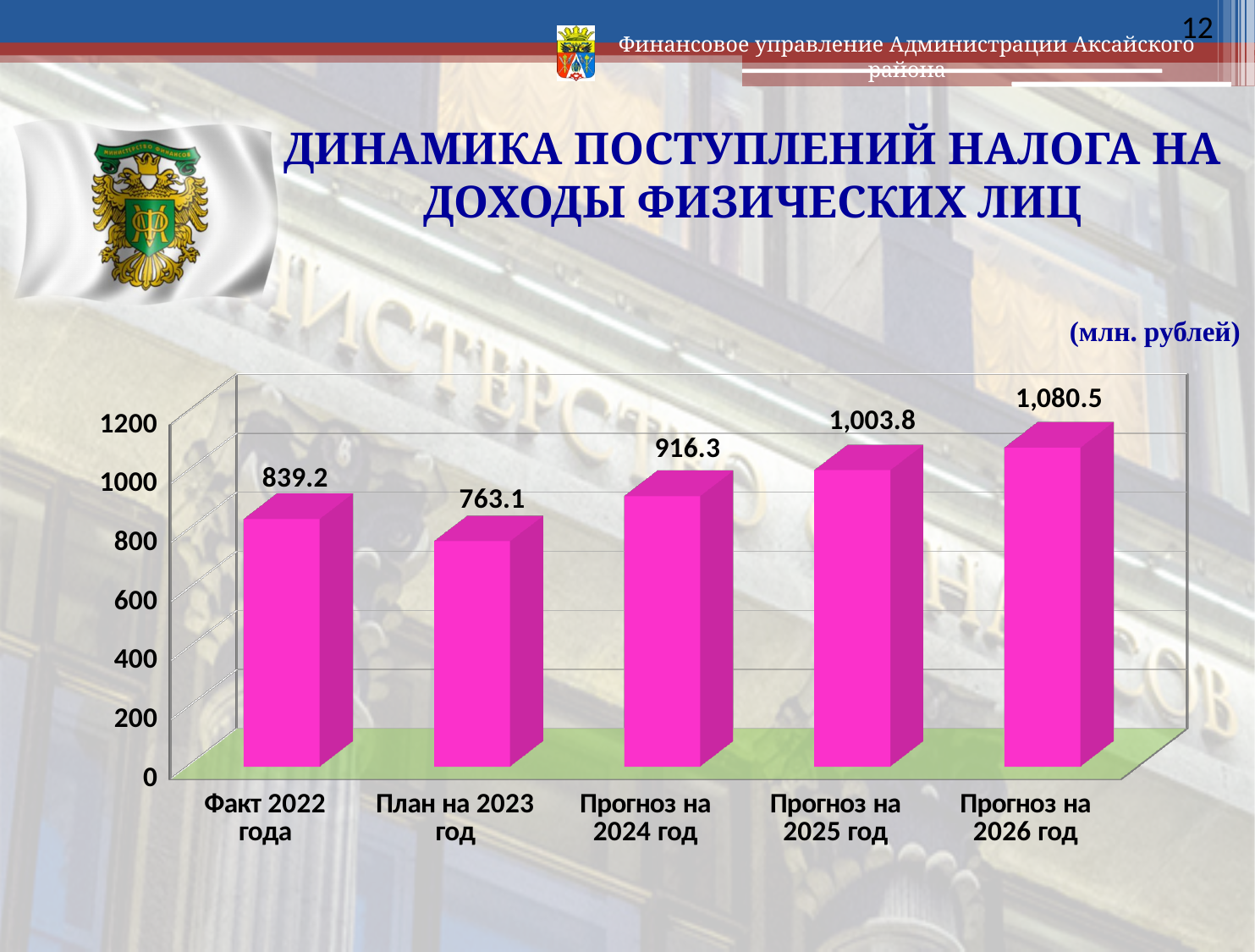
Which category has the lowest value? План на 2023 год What is the difference between the values for Прогноз на 2024 год and План на 2023 год? 153.2 What unit of measurement is indicated for the chart values? млн. рублей Is the value for Прогноз на 2024 год greater or less than 1000? less Which is larger, the value for Факт 2022 года or the value for План на 2023 год? Факт 2022 года What is the value for План на 2023 год? 763.1 What kind of chart is shown on the slide? bar chart What is the value for Факт 2022 года? 839.2 Which category has the highest value? Прогноз на 2026 год How many categories are shown on the chart? 5 What is the difference between the values for Прогноз на 2026 год and Факт 2022 года? 241.3 What is the value for Прогноз на 2025 год? 1,003.8